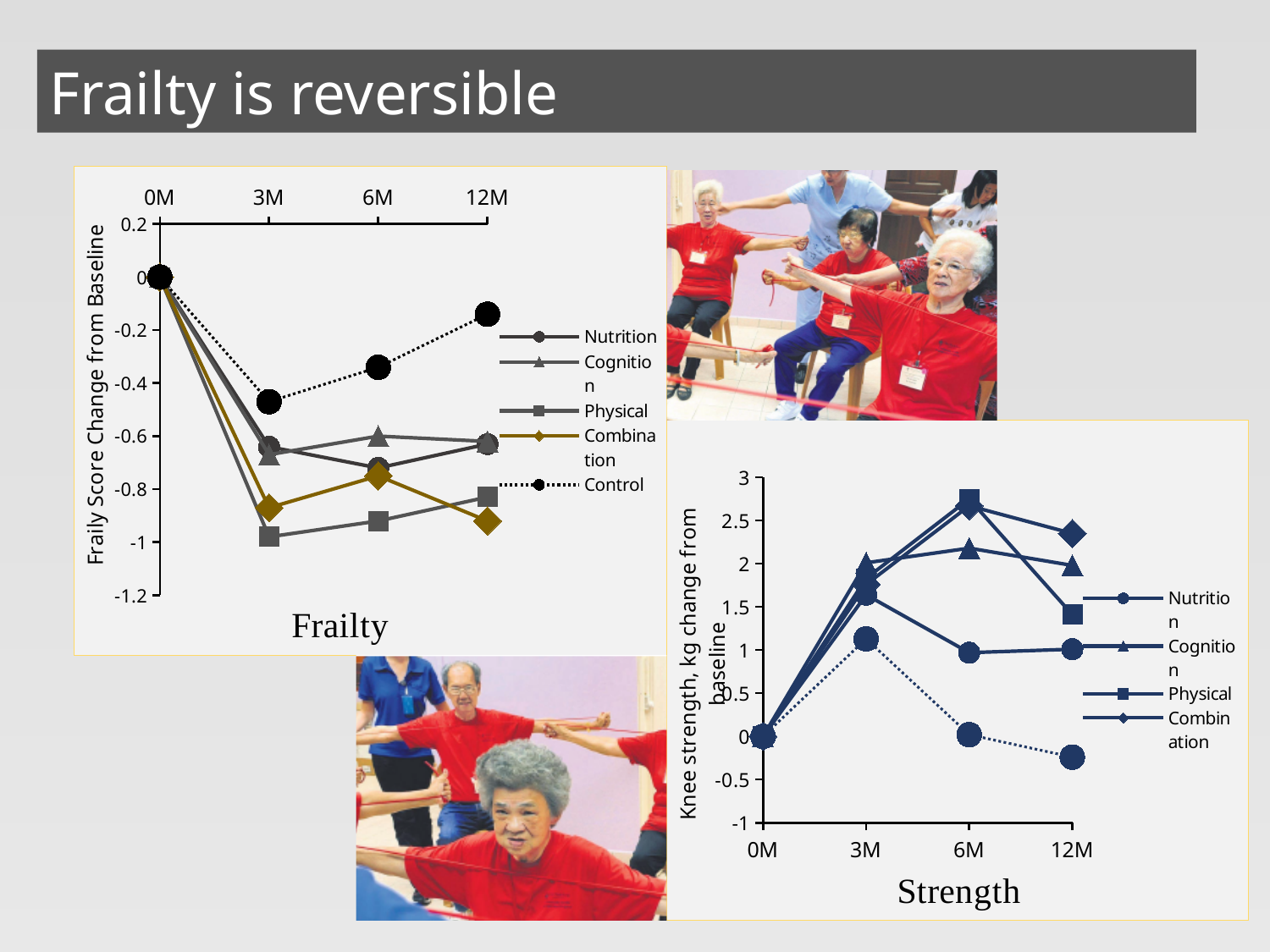
On the Frailty chart, is the value for Physical at 3M greater or less than -0.8? less On the Strength chart, which series has the highest value at 6M? Physical On the Strength chart, is the value for Combination at 12M greater or less than 2? greater On the Frailty chart, which series has the highest value at 12M? Control On the Strength chart, what is the label of the y axis? Knee strength, kg change from baseline On the Frailty chart, which series has the lowest value at 3M? Physical On the Frailty chart, does the Control line rise or fall from 3M to 12M? rise On the Frailty chart, how many time points are plotted along the x axis? 4 On the Frailty chart, is the value for Control at 3M greater or less than -0.4? less On the Frailty chart, how many series does the legend list? 5 On the Strength chart, how many series does the legend list? 4 On the Frailty chart, what kind of chart is shown? line chart